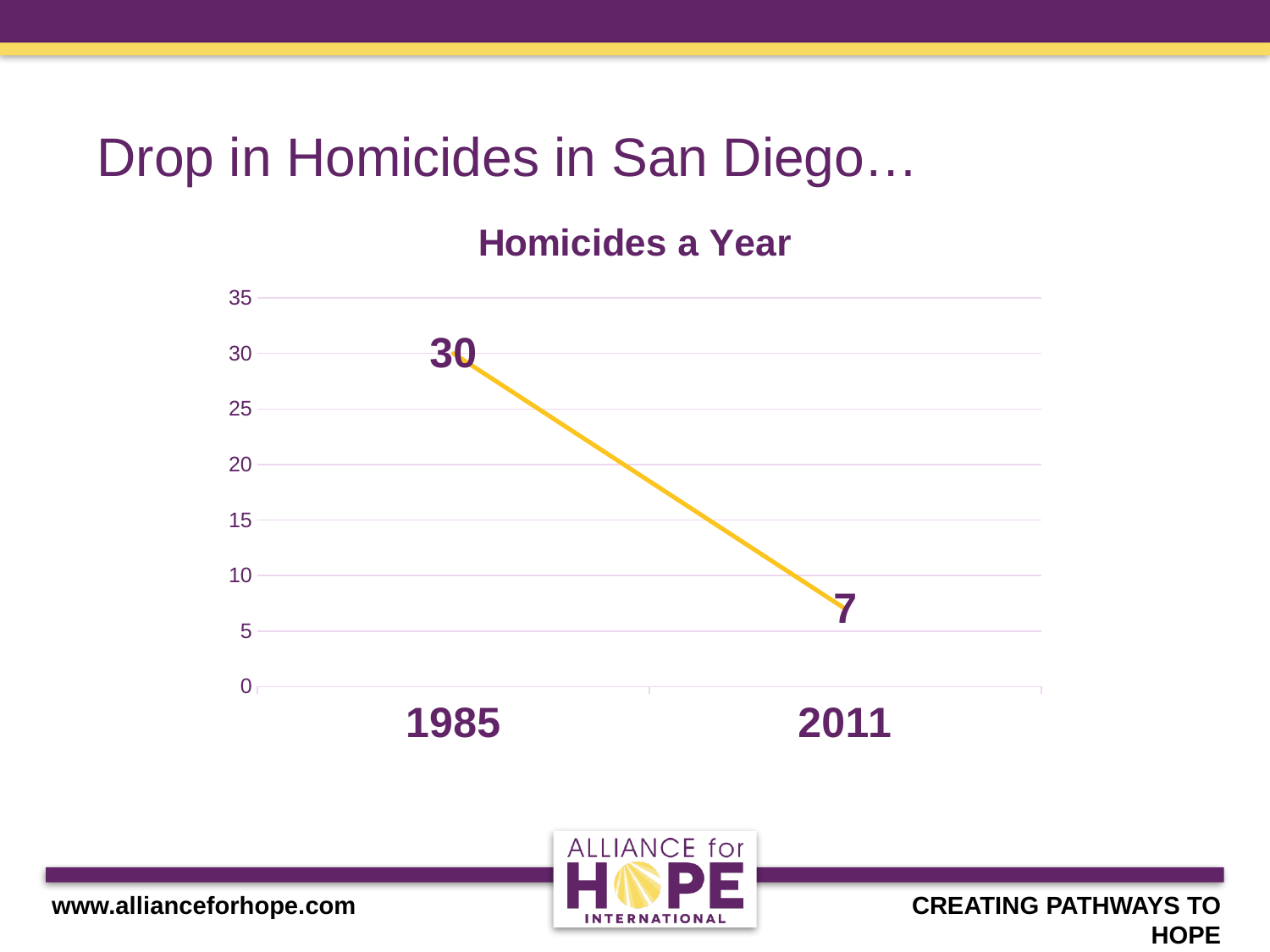
What kind of chart is shown? line chart How many data points are plotted on the chart? 2 Which is larger, the value for 1985 or the value for 2011? 1985 What is the difference between the values for 1985 and 2011? 23 Do the values rise or fall from 1985 to 2011? fall Which year has the highest number of homicides? 1985 Which year has the lowest number of homicides? 2011 Is the value for 2011 greater or less than 10? less What is the value for 1985? 30 What is the value for 2011? 7 Is the value for 1985 greater or less than 25? greater What is the title of the chart? Homicides a Year